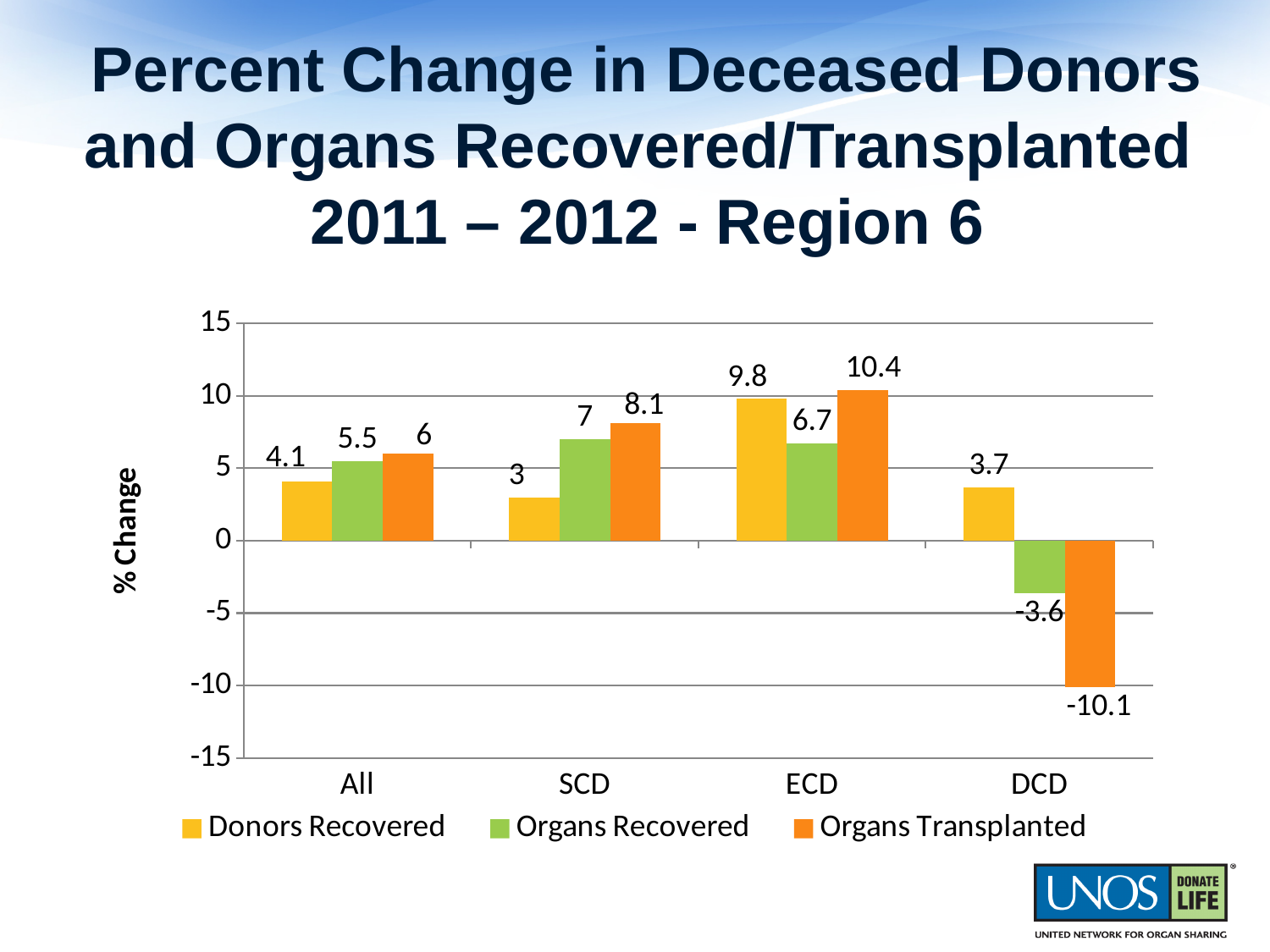
What is the label of the y axis? % Change What is the percent change in Donors Recovered for ECD? 9.8 Which category has the lowest Organs Recovered value? DCD What is the percent change in Organs Transplanted for DCD? -10.1 What kind of chart is shown on the slide? Bar chart What is the percent change in Organs Recovered for SCD? 7 What is the difference between the Organs Transplanted and Donors Recovered values for SCD? 5.1 What is the percent change in Organs Transplanted for All? 6 Which is larger for ECD: Donors Recovered or Organs Recovered? Donors Recovered How many series does the legend list? 3 Which category has the highest Organs Transplanted value? ECD How many categories are shown on the x axis? 4